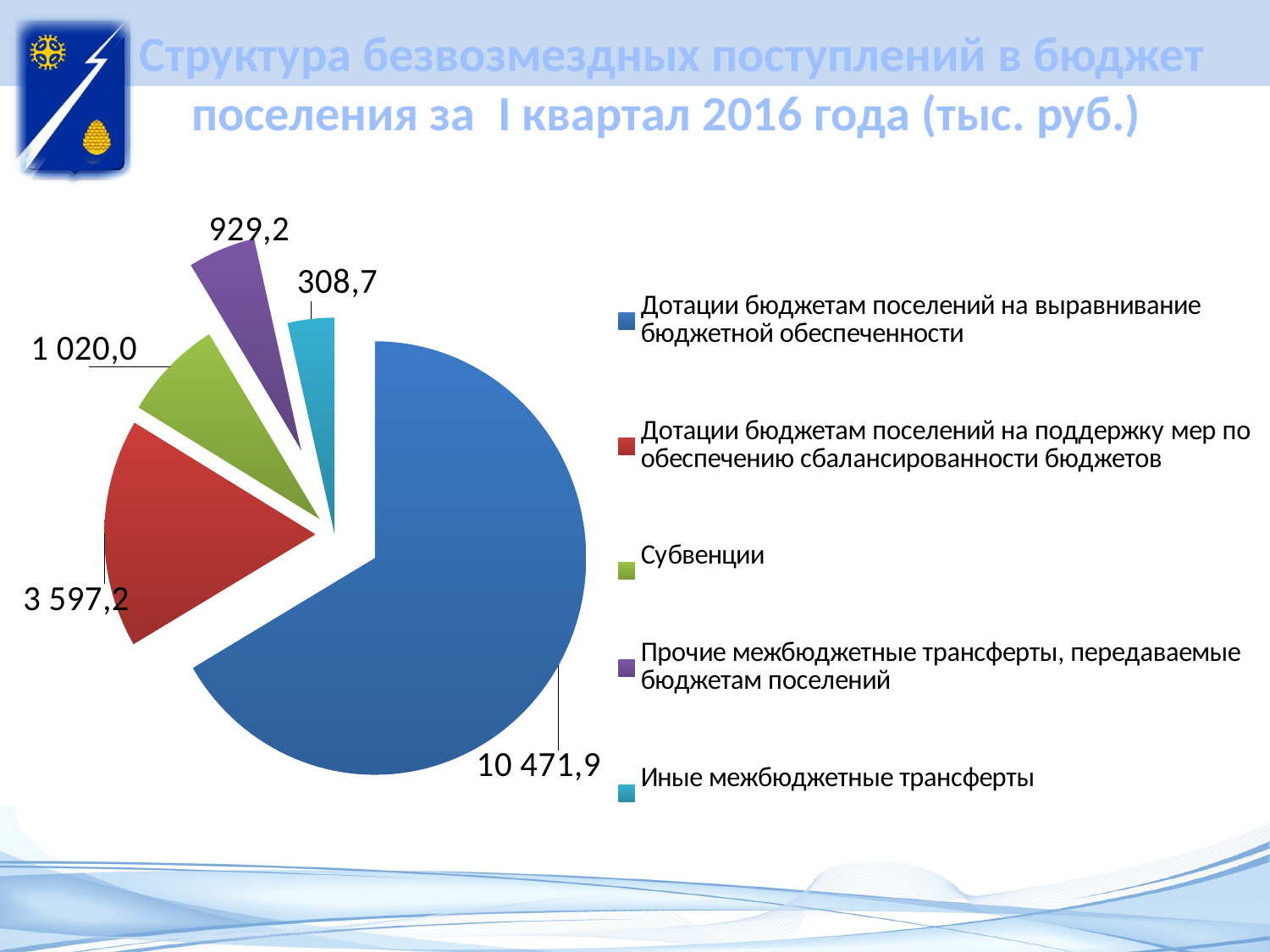
How many slices does the pie chart have? 5 What kind of chart is shown on the slide? pie chart Which is larger: the value for Субвенции or the value for Прочие межбюджетные трансферты, передаваемые бюджетам поселений? Субвенции What is the value for Прочие межбюджетные трансферты, передаваемые бюджетам поселений? 929,2 What is the difference between the value for Дотации бюджетам поселений на выравнивание бюджетной обеспеченности and the value for Дотации бюджетам поселений на поддержку мер по обеспечению сбалансированности бюджетов? 6 874,7 What colour is the slice for Субвенции? green What is the value for Иные межбюджетные трансферты? 308,7 What is the value for Дотации бюджетам поселений на поддержку мер по обеспечению сбалансированности бюджетов? 3 597,2 Which category has the largest slice of the pie? Дотации бюджетам поселений на выравнивание бюджетной обеспеченности Which category has the smallest slice of the pie? Иные межбюджетные трансферты What is the value for Субвенции? 1 020,0